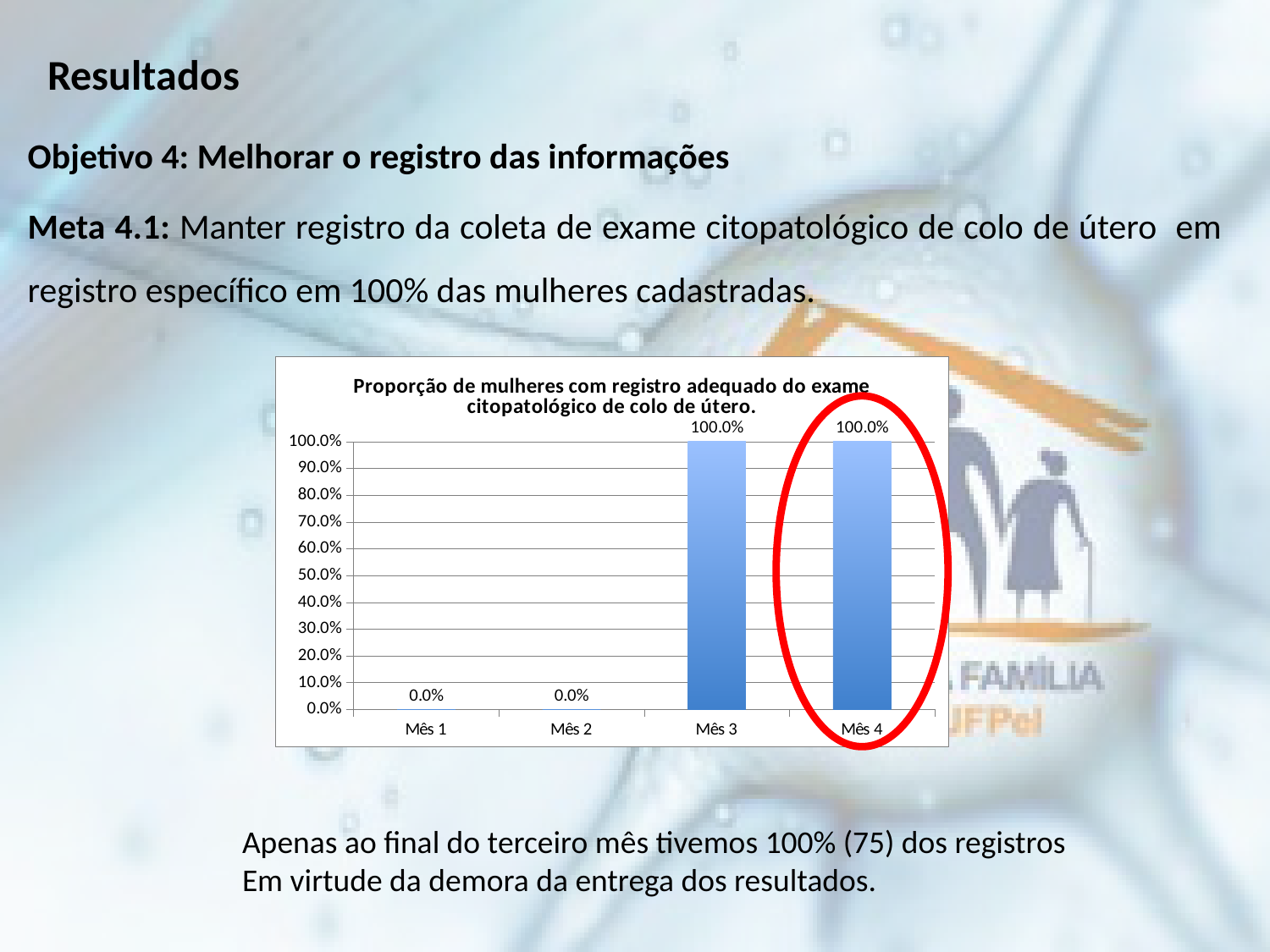
Is the value for Mês 3 greater or less than 50.0%? greater What kind of chart is shown on the slide? bar chart What is the value for Mês 2? 0.0% What is the value for Mês 4? 100.0% What is the value for Mês 1? 0.0% Do the values rise or fall from Mês 2 to Mês 3? rise What is the title of the chart? Proporção de mulheres com registro adequado do exame citopatológico de colo de útero. How many categories are shown on the x axis? 4 Which category on the chart is circled in red? Mês 4 What is the difference between the values for Mês 3 and Mês 1? 100.0% Which category has the lowest value, Mês 2 or Mês 3? Mês 2 What is the value for Mês 3? 100.0%